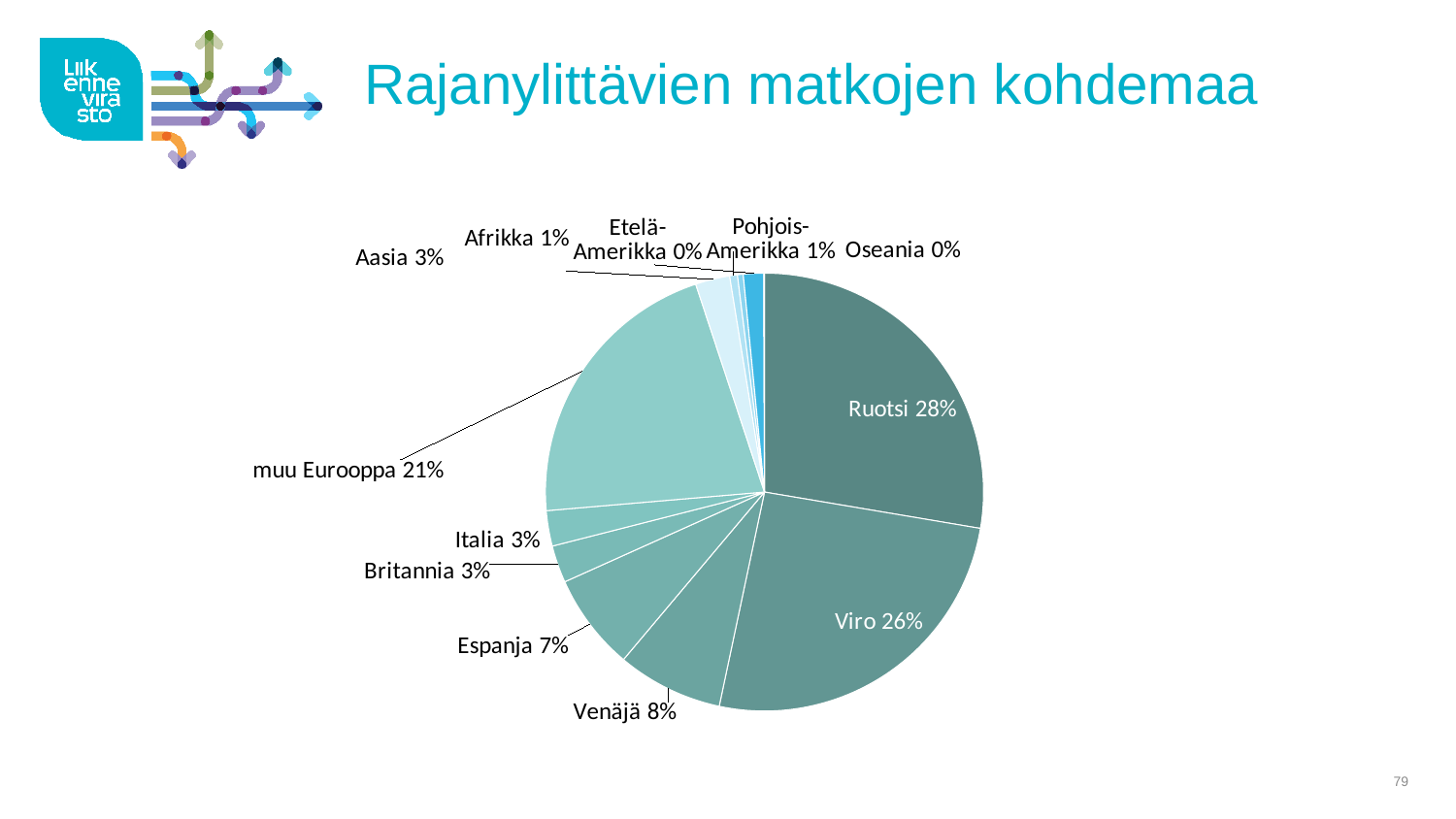
Which category has the largest slice of the pie? Ruotsi What share of the pie does Viro have? 26% What is the title of the chart on the slide? Rajanylittävien matkojen kohdemaa Which is larger, the share for Venäjä or the share for Espanja? Venäjä What share of the pie does Aasia have? 3% What share of the pie does muu Eurooppa have? 21% What is the difference in percentage points between Ruotsi and Viro? 2 percentage points What share of the pie does Espanja have? 7% What share of the pie does Venäjä have? 8% How many categories are labelled on the pie chart? 12 What share of the pie does Ruotsi have? 28% What kind of chart is shown on the slide? Pie chart